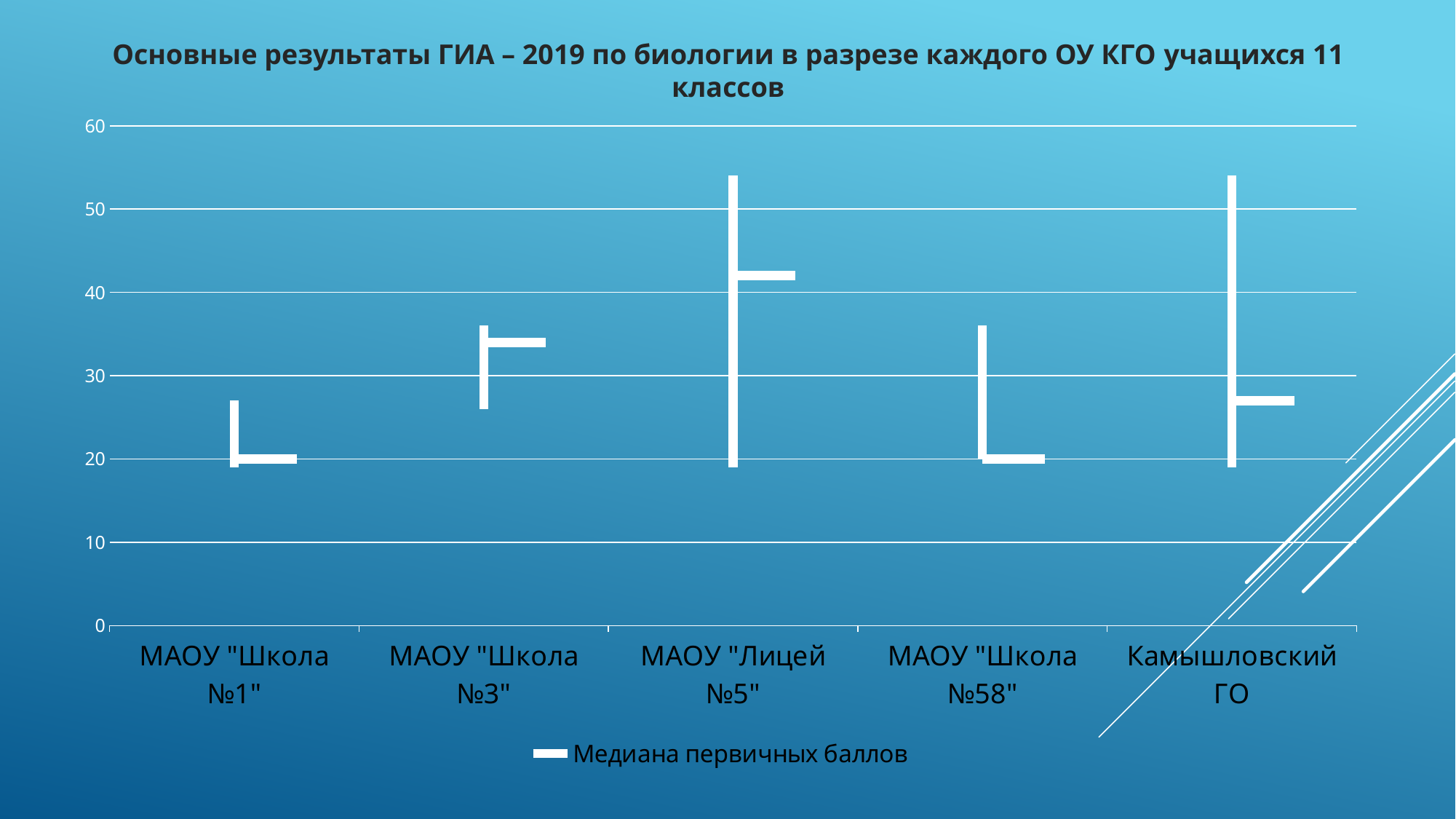
Is the median primary score for МАОУ "Лицей №5" greater or less than 40? greater Is the median primary score for МАОУ "Школа №1" greater or less than 30? less Which has the higher median primary score, МАОУ "Лицей №5" or МАОУ "Школа №3"? МАОУ "Лицей №5" Which has the higher median primary score, МАОУ "Школа №3" or Камышловский ГО? МАОУ "Школа №3" Which institution has the highest median primary score? МАОУ "Лицей №5" Is the median primary score for МАОУ "Школа №58" greater or less than 30? less What series does the legend list? Медиана первичных баллов How many educational institutions (categories) are shown on the x axis? 5 What is the title of the chart? Основные результаты ГИА – 2019 по биологии в разрезе каждого ОУ КГО учащихся 11 классов How many series does the legend list? 1